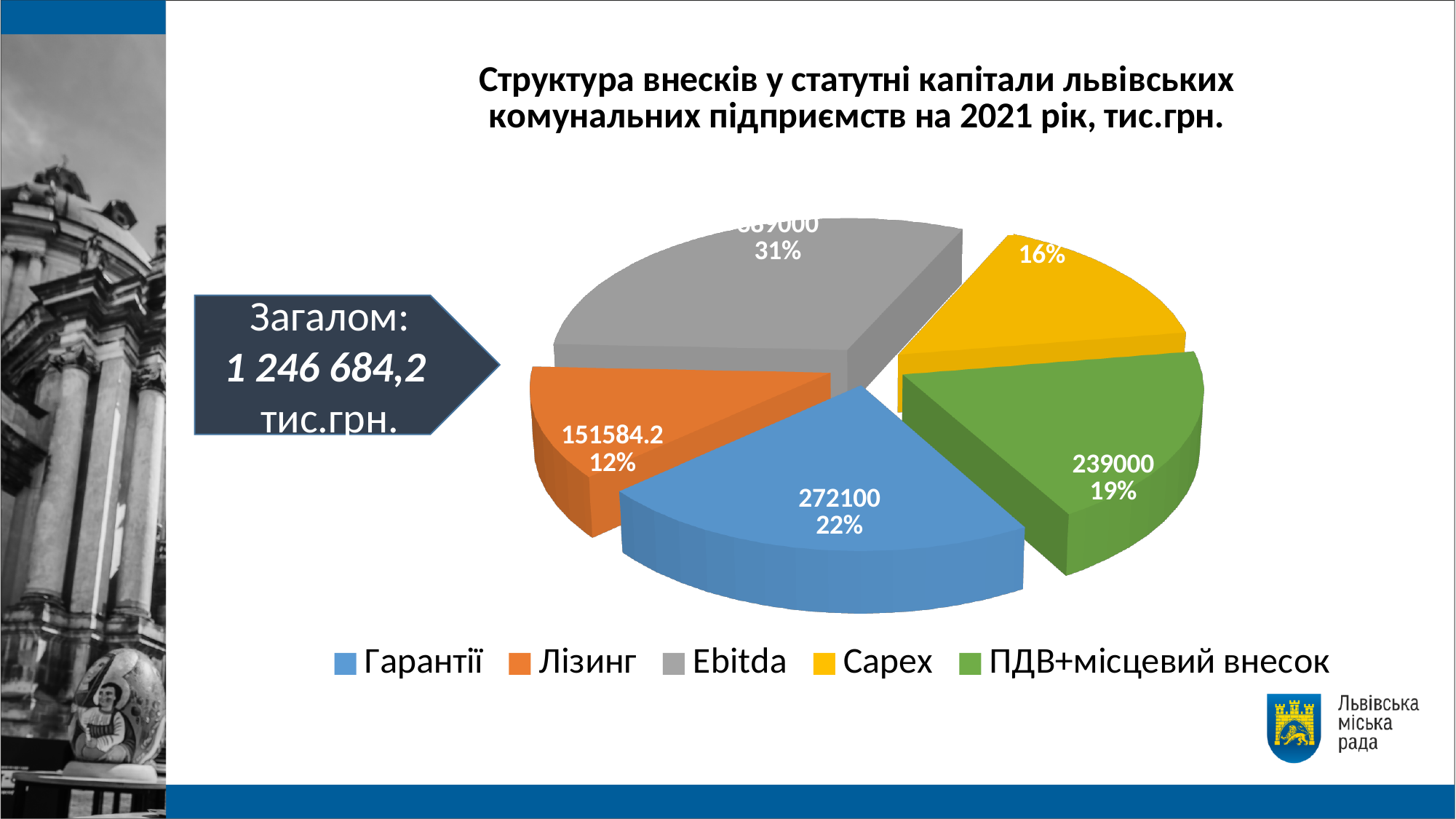
What is the value shown for Лізинг? 151584.2 What kind of chart is shown on the slide? Pie chart Which is larger, the share for Capex or the share for ПДВ+місцевий внесок? ПДВ+місцевий внесок What share of the pie does Capex represent? 16% What share of the pie does Ebitda represent? 31% Which category has the smallest share of the pie? Лізинг How many slices does the pie chart have? 5 How many entries does the legend list? 5 What is the difference between the values for Гарантії and ПДВ+місцевий внесок? 33100 Which category has the largest share of the pie? Ebitda What is the value shown for Гарантії? 272100 What is the value shown for ПДВ+місцевий внесок? 239000